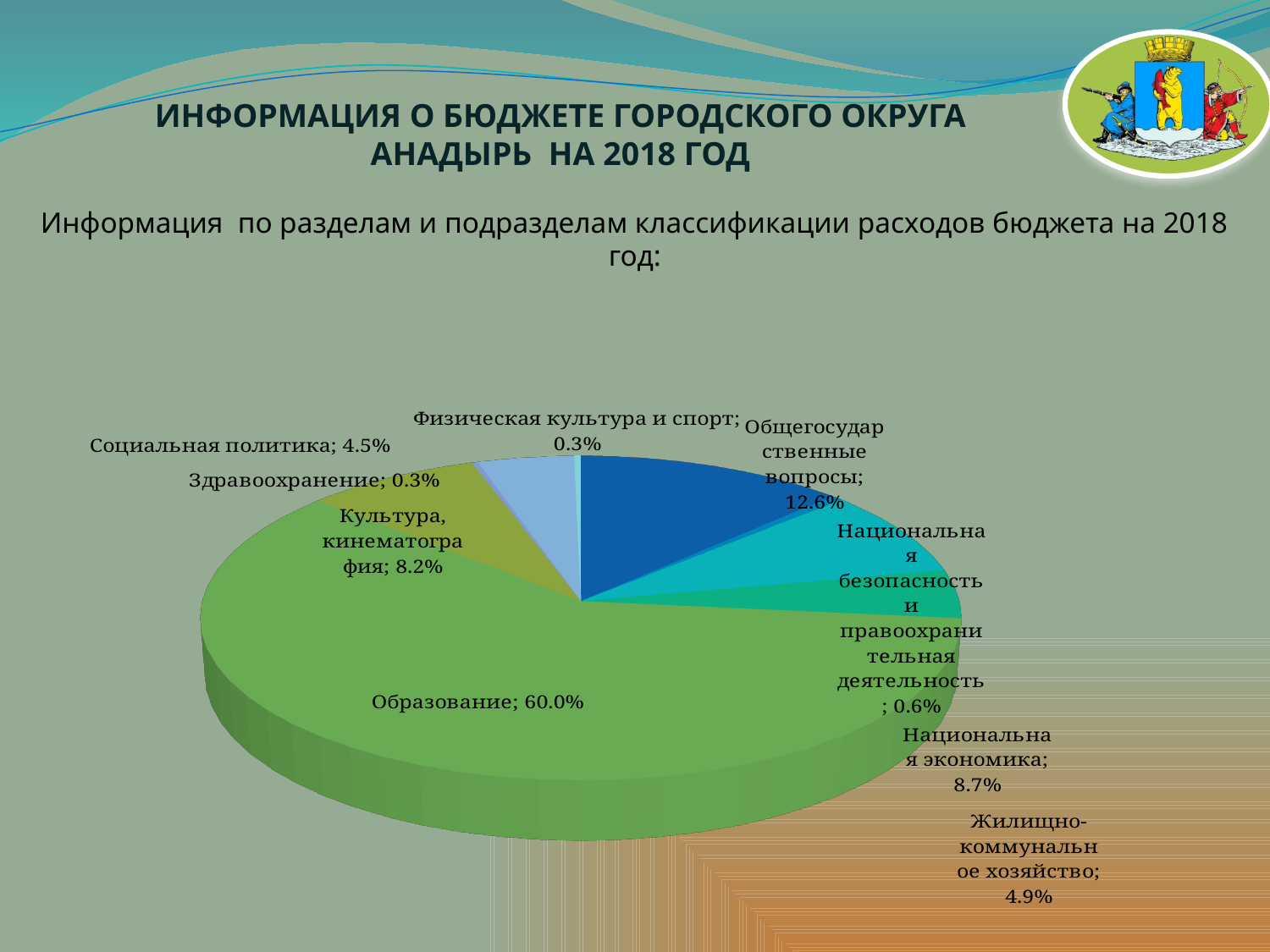
What is the value for Социальная политика? 4.5% What kind of chart is shown on the slide? Pie chart What share is labelled for Культура, кинематография? 8.2% What is the value shown for Национальная безопасность и правоохранительная деятельность? 0.6% What is the value for Жилищно-коммунальное хозяйство? 4.9% What share of the budget expenditure goes to Образование? 60.0% Which is larger: the share for Жилищно-коммунальное хозяйство or for Социальная политика? Жилищно-коммунальное хозяйство What is the value shown for Общегосударственные вопросы? 12.6% Which category has the largest slice of the pie? Образование How many categories are shown in the pie chart? 9 What percentage is shown for Национальная экономика? 8.7% What is the difference between the shares for Общегосударственные вопросы and Национальная экономика? 3.9%